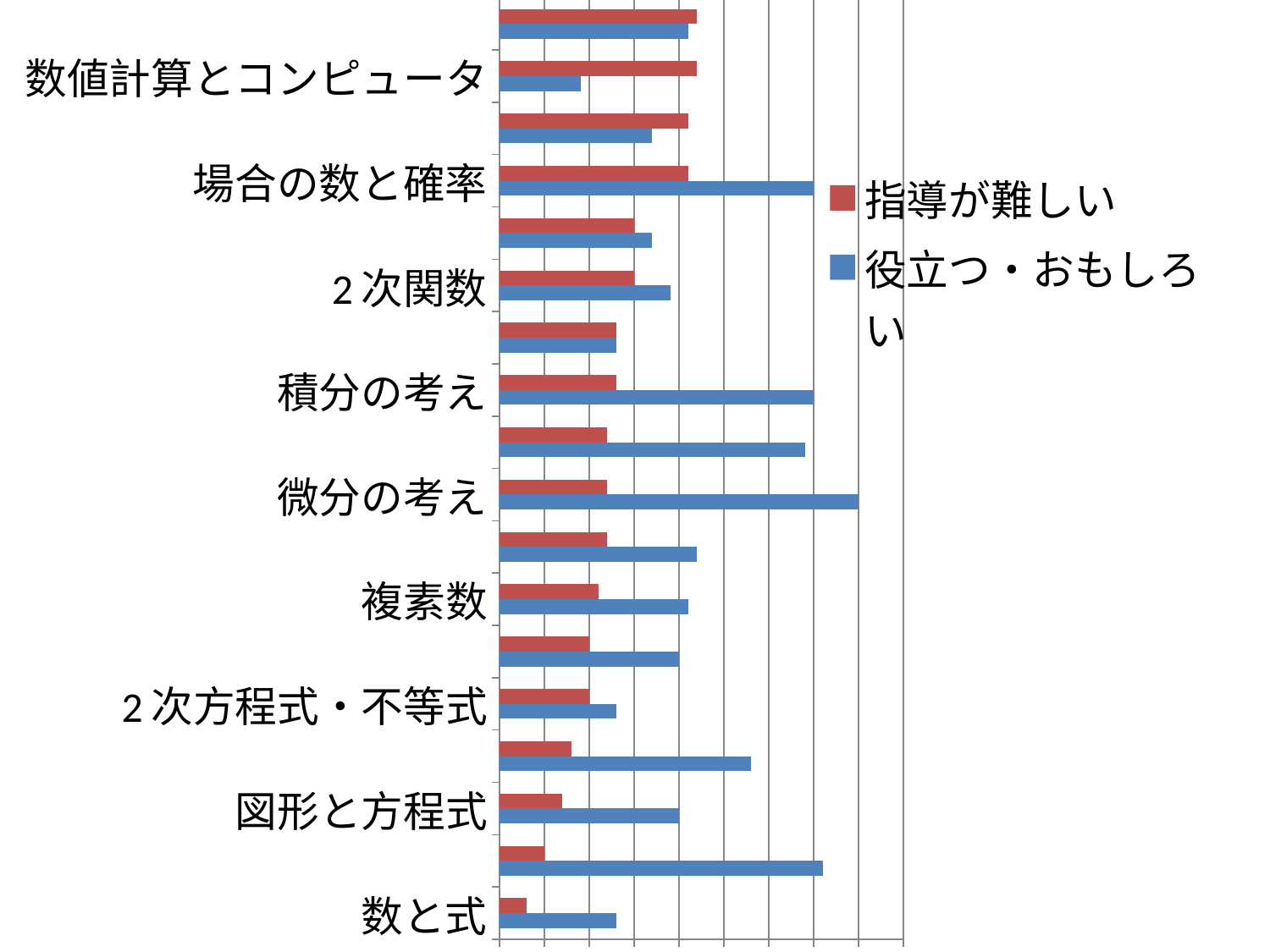
Which labelled category has the shortest 指導が難しい bar? 数と式 For 積分の考え, is the 役立つ・おもしろい bar longer or shorter than the 指導が難しい bar? longer For 微分の考え, which series has the longer bar, 指導が難しい or 役立つ・おもしろい? 役立つ・おもしろい What are the two series named in the legend? 指導が難しい and 役立つ・おもしろい Which labelled category has the longest 役立つ・おもしろい bar? 微分の考え For 図形と方程式, which series has the longer bar? 役立つ・おもしろい What kind of chart is shown on the slide? bar chart Which colour represents the 指導が難しい series? red How many series does the legend list? 2 Going from the top of the chart to the bottom, do the 指導が難しい bars get longer or shorter? shorter